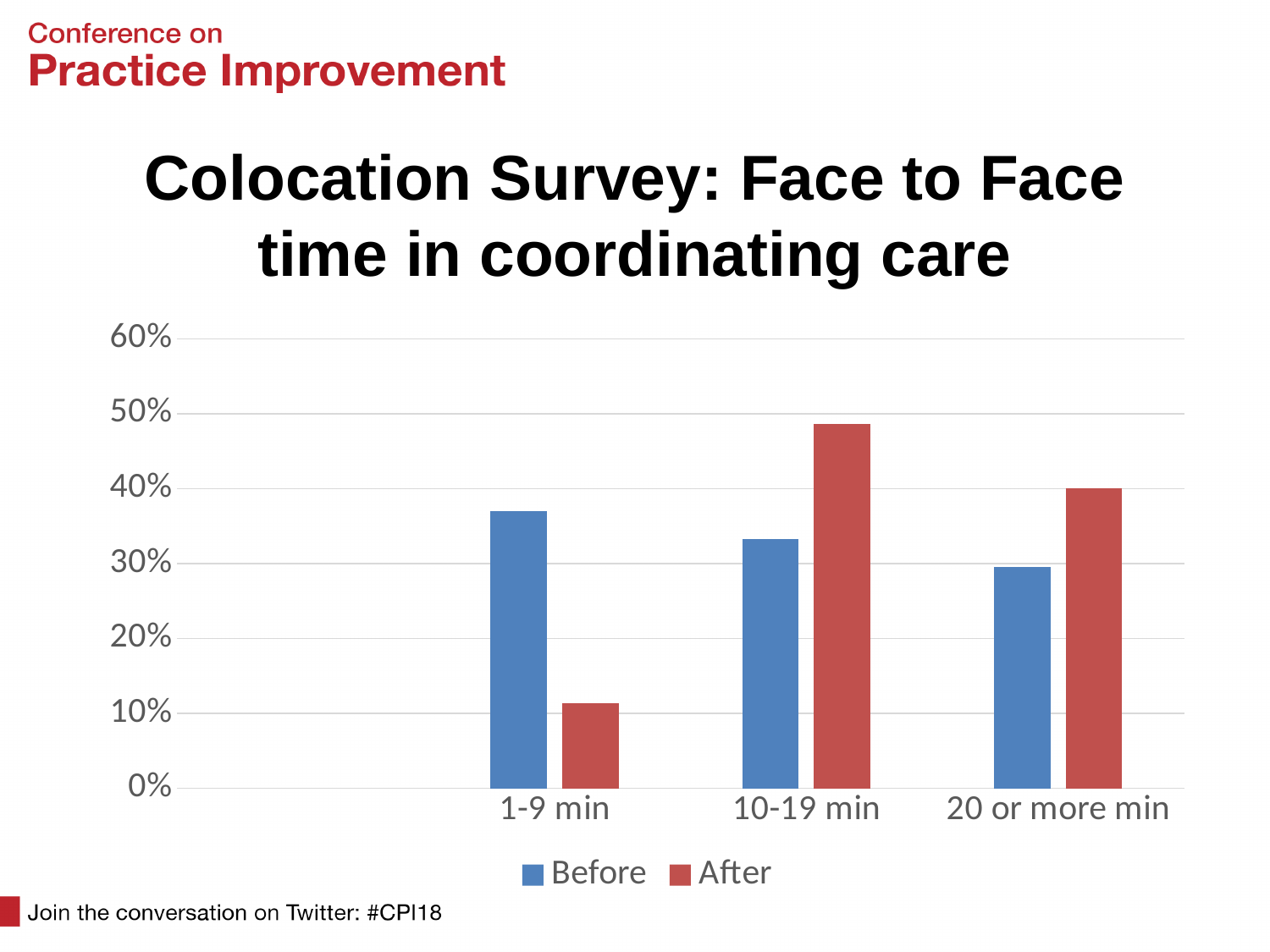
Which category has the highest Before value? 1-9 min How many categories are shown on the x axis? 3 Do the Before values rise or fall from 1-9 min to 20 or more min? fall For 1-9 min, which is larger, Before or After? Before Which category has the highest After value? 10-19 min For 10-19 min, which is larger, Before or After? After What kind of chart is shown on the slide? bar chart How many series does the legend list? 2 What are the two entries in the legend? Before and After Which category has the lowest After value? 1-9 min Is the After value for 1-9 min greater or less than 20%? less Is the After value for 10-19 min greater or less than 40%? greater